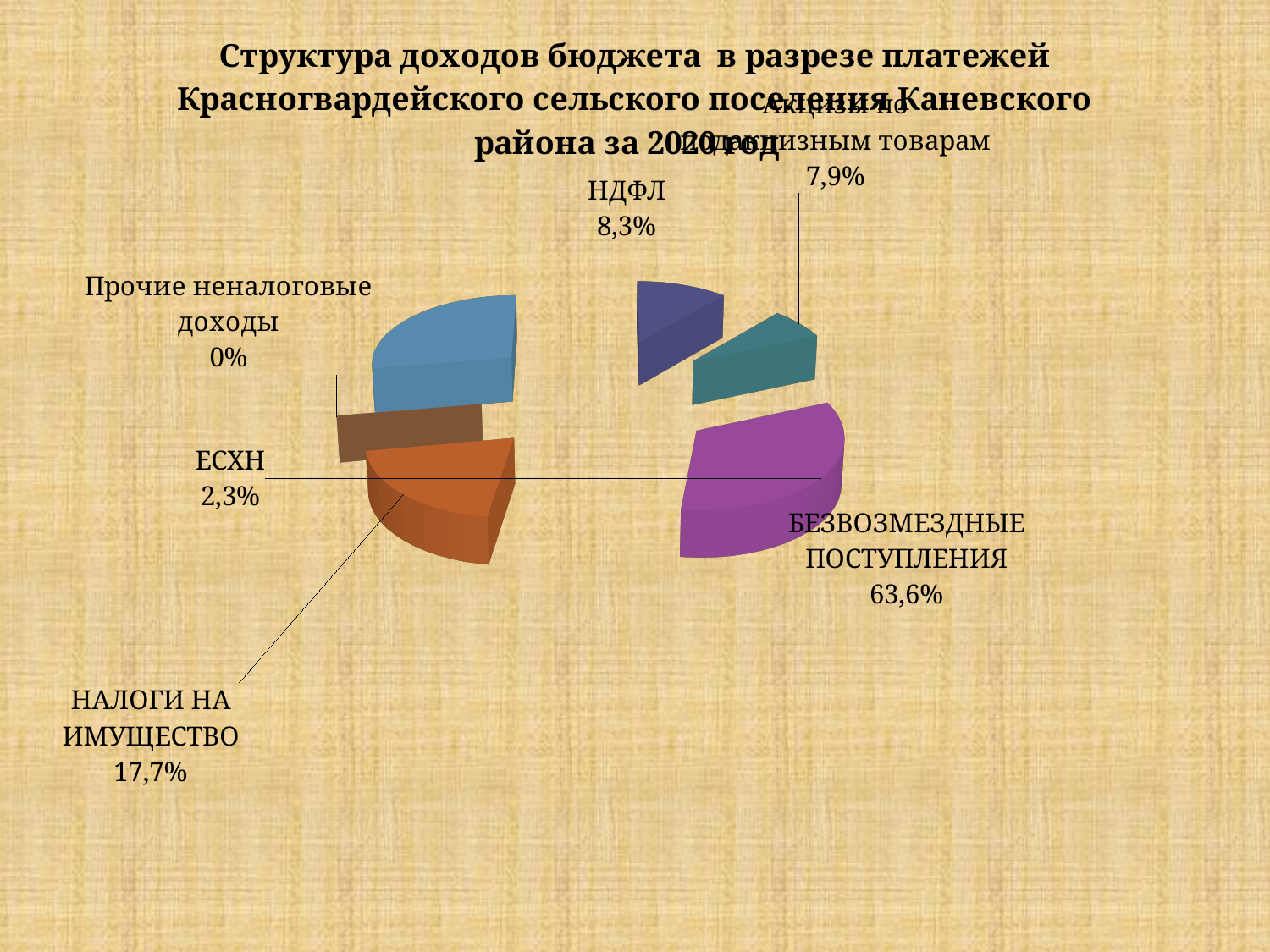
How many categories are shown in the pie chart? 6 What is the difference between the shares of БЕЗВОЗМЕЗДНЫЕ ПОСТУПЛЕНИЯ and НАЛОГИ НА ИМУЩЕСТВО? 45,9% Which category has the smallest share of the pie? Прочие неналоговые доходы Which category has the largest share of the pie? БЕЗВОЗМЕЗДНЫЕ ПОСТУПЛЕНИЯ What is the value shown for НДФЛ? 8,3% What share of the pie does БЕЗВОЗМЕЗДНЫЕ ПОСТУПЛЕНИЯ have? 63,6% Which is larger, the share for НДФЛ or the share for Акцизы по подакцизным товарам? НДФЛ What is the value shown for Акцизы по подакцизным товарам? 7,9% What is the value shown for НАЛОГИ НА ИМУЩЕСТВО? 17,7% What is the value shown for ЕСХН? 2,3% What kind of chart is shown on the slide? Pie chart What is the value shown for Прочие неналоговые доходы? 0%